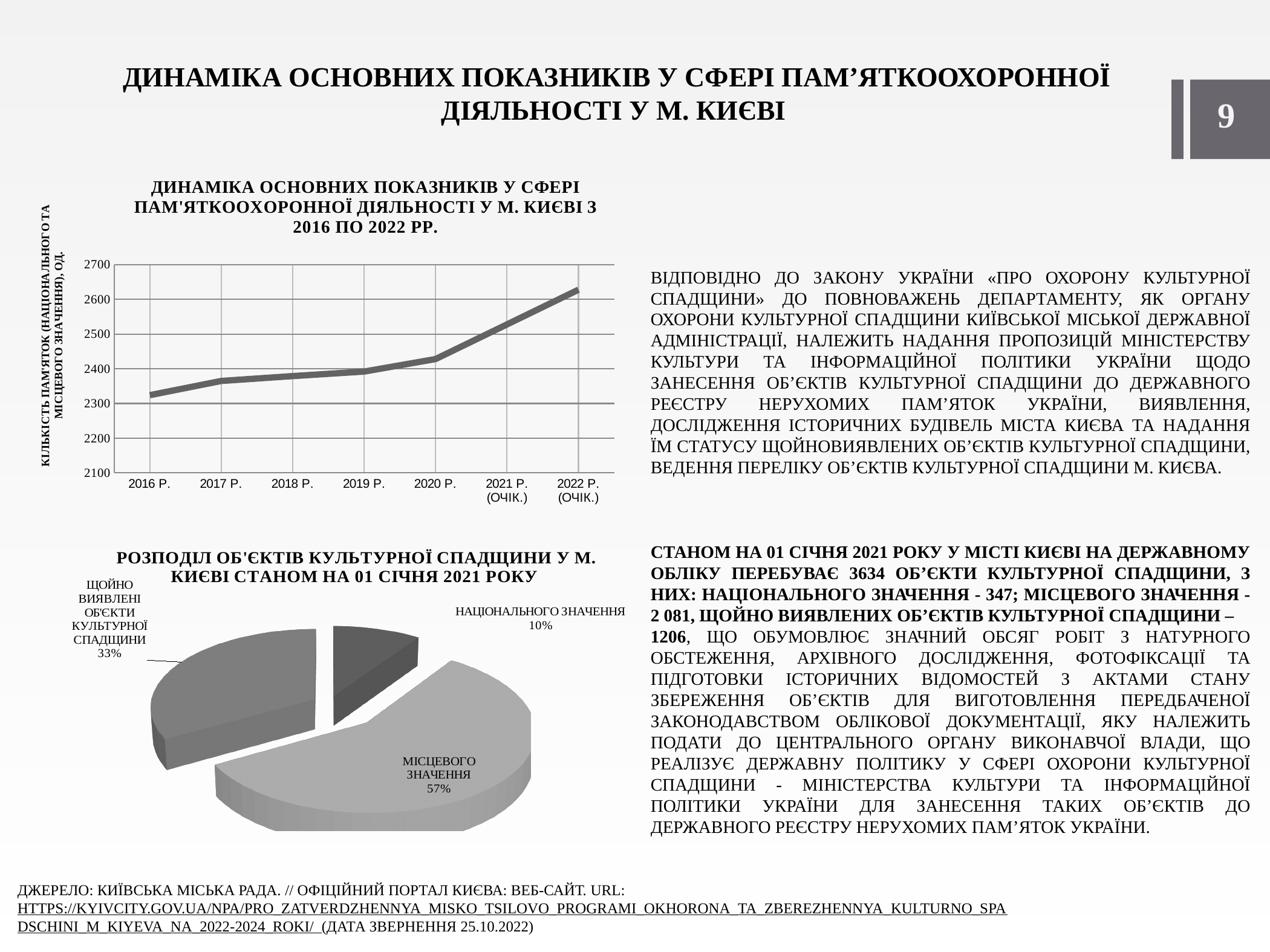
What type of chart is the bottom-left chart on the slide? Pie chart In the pie chart at the bottom left, how many percentage points larger is the share of місцевого значення than the share of щойно виявлені об'єкти? 24 In the line chart at the top left, do the values rise or fall from 2016 to 2022? Rise In the line chart 'Динаміка основних показників у сфері пам'яткоохоронної діяльності у м. Києві з 2016 по 2022 рр.', how many years are shown on the x axis? 7 In the pie chart at the bottom left, which category has the smallest share? Національного значення In the pie chart 'Розподіл об'єктів культурної спадщини у м. Києві станом на 01 січня 2021 року', what share do objects of місцевого значення have? 57% In the pie chart at the bottom left, what share do objects of національного значення have? 10% In the pie chart at the bottom left, how many slices are there? 3 In the line chart at the top left, is the value for 2016 р. greater or less than 2400? less In the pie chart at the bottom left, which category has the largest share? Місцевого значення In the pie chart at the bottom left, what share do щойно виявлені об'єкти культурної спадщини have? 33% In the line chart at the top left, is the value for 2022 р. (очік.) greater or less than 2600? greater